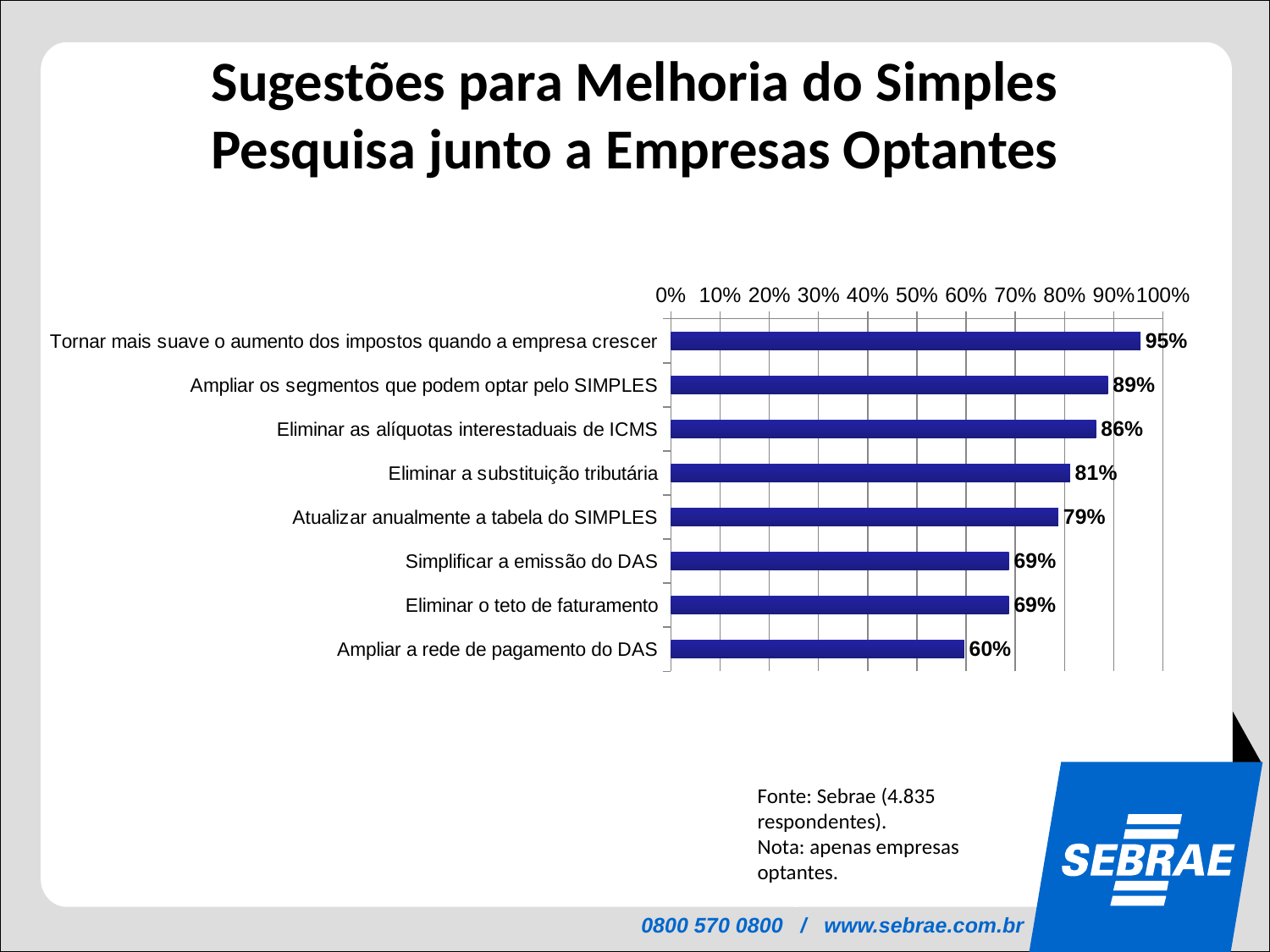
Is the value for "Eliminar o teto de faturamento" greater or less than 80%? less What is the difference between the values for "Ampliar os segmentos que podem optar pelo SIMPLES" and "Eliminar a substituição tributária"? 8% What is the value for "Ampliar a rede de pagamento do DAS"? 60% What is the value for "Eliminar as alíquotas interestaduais de ICMS"? 86% What kind of chart is shown on the slide? bar chart Which is larger: the value for "Eliminar as alíquotas interestaduais de ICMS" or the value for "Simplificar a emissão do DAS"? Eliminar as alíquotas interestaduais de ICMS What is the value for "Tornar mais suave o aumento dos impostos quando a empresa crescer"? 95% What is the value for "Atualizar anualmente a tabela do SIMPLES"? 79% Which category has the lowest value? Ampliar a rede de pagamento do DAS Which category has the highest value? Tornar mais suave o aumento dos impostos quando a empresa crescer What is the source cited for the chart data? Sebrae (4.835 respondentes) How many categories are shown in the chart? 8